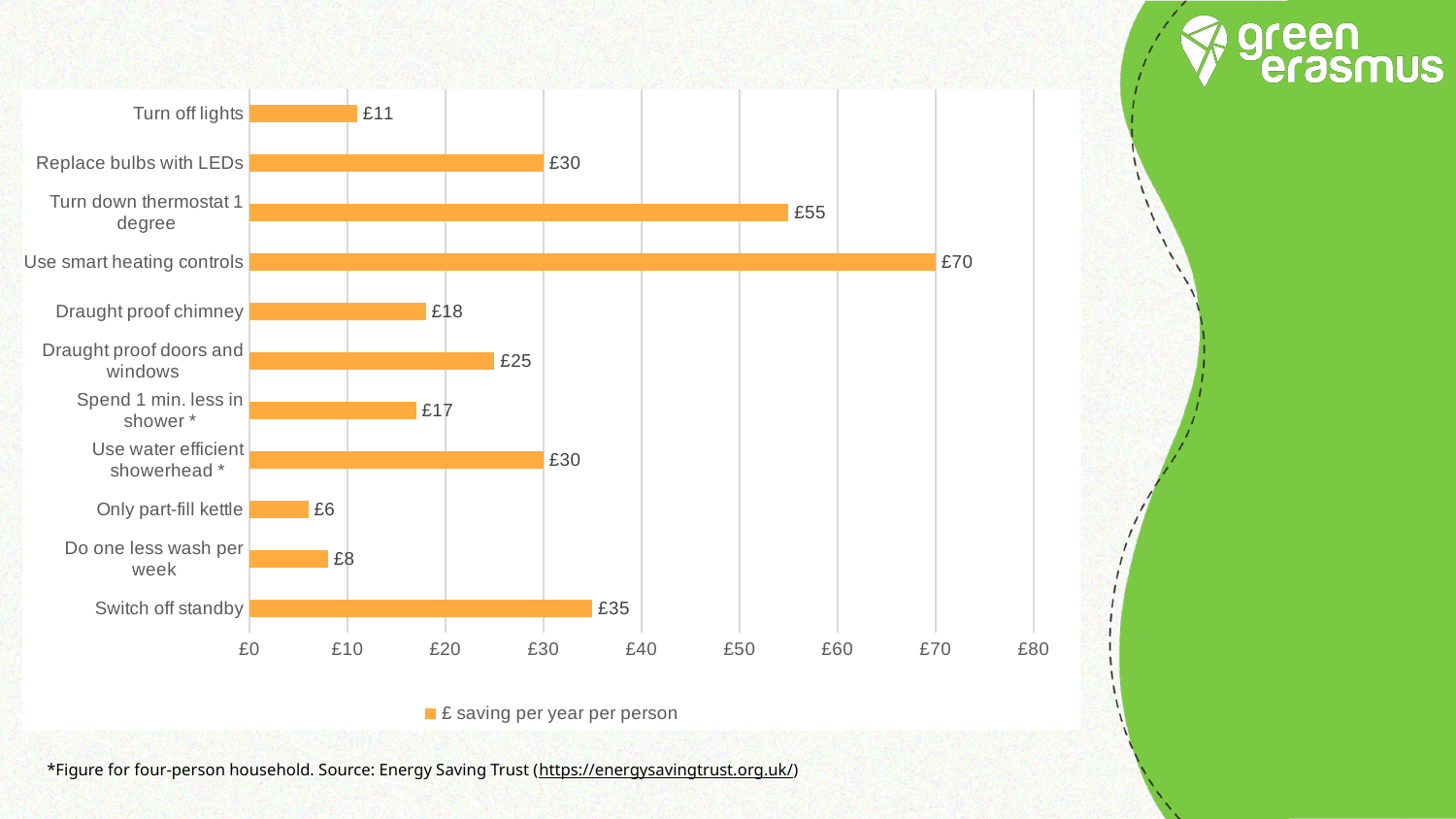
How many series does the legend list? 1 What is the £ saving per year per person for 'Draught proof chimney'? £18 Which has a larger £ saving per year per person: 'Draught proof doors and windows' or 'Spend 1 min. less in shower *'? Draught proof doors and windows What is the difference in £ saving per year per person between 'Turn down thermostat 1 degree' and 'Replace bulbs with LEDs'? £25 What is the legend entry for the series in the chart? £ saving per year per person What is the £ saving per year per person for 'Use smart heating controls'? £70 How many categories are shown in the chart? 11 What kind of chart is shown on the slide? Bar chart Which category has the lowest £ saving per year per person? Only part-fill kettle What is the £ saving per year per person for 'Switch off standby'? £35 Which category has the highest £ saving per year per person? Use smart heating controls Is the value for 'Turn down thermostat 1 degree' greater or less than £50? greater